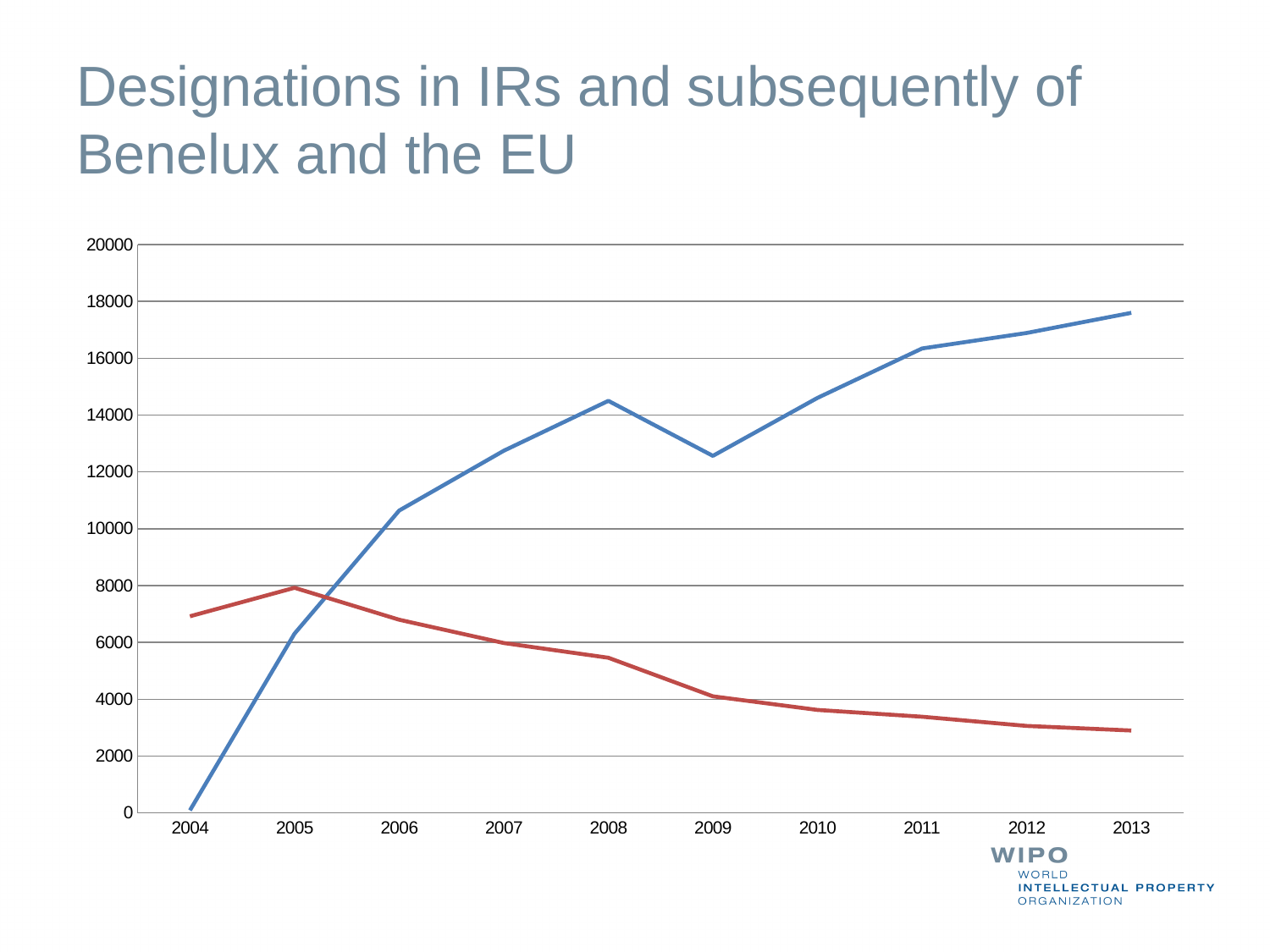
In which year does the blue line reach its highest value? 2013 What is the title of the chart on the slide? Designations in IRs and subsequently of Benelux and the EU How many lines are plotted on the chart? 2 Does the red line rise or fall from 2005 to 2013? fall In which year does the red line have its lowest value? 2013 Is the value of the red line in 2013 greater or less than 4000? less In which year does the blue line have its lowest value? 2004 Is the value of the blue line in 2013 greater or less than 16000? greater In which year does the red line reach its highest value? 2005 What kind of chart is shown on the slide? line chart Does the blue line generally rise or fall from 2004 to 2013? rise How many years are shown along the x axis of the chart? 10